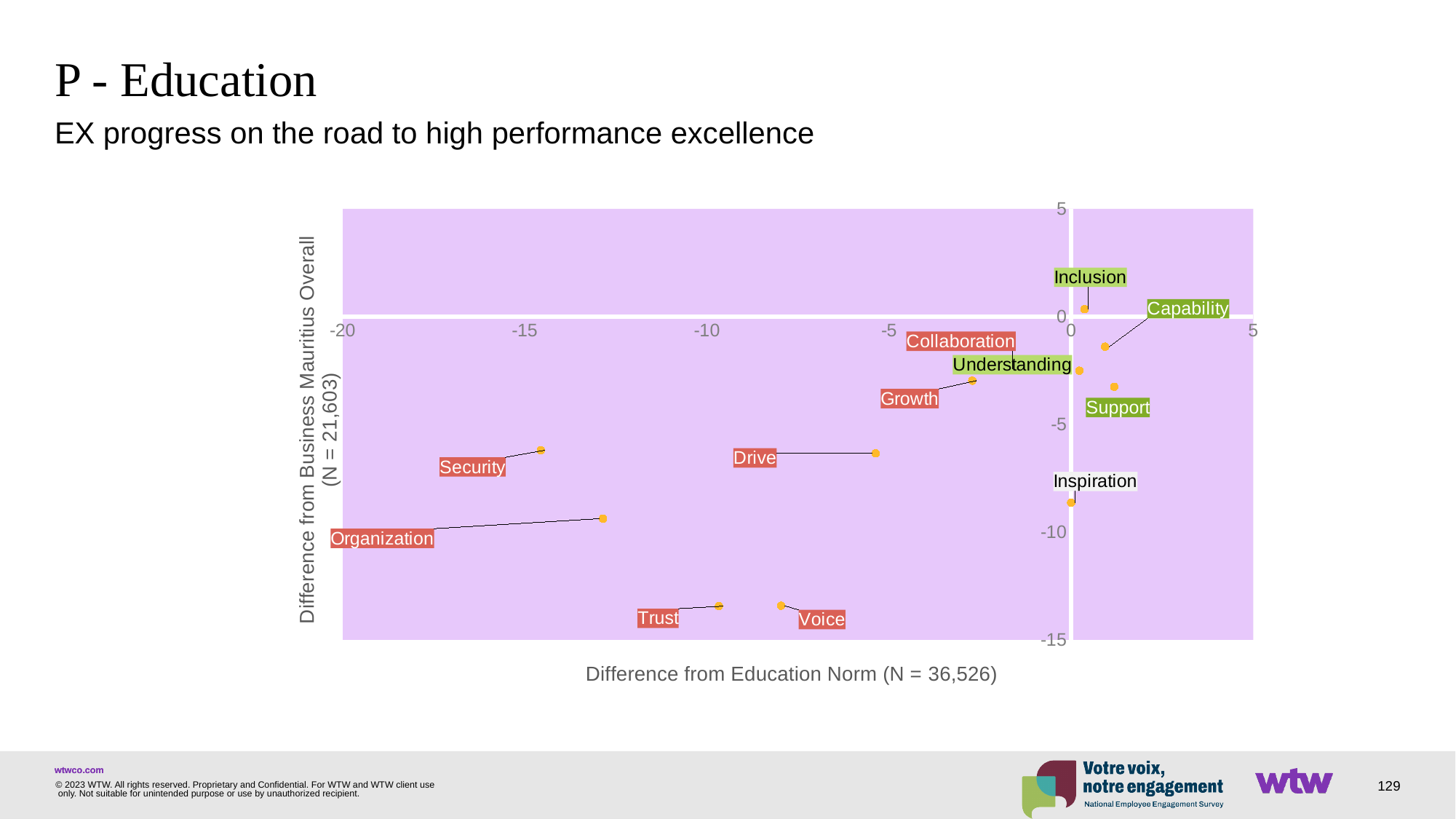
Which has the higher vertical-axis value, Organization or Security? Security Is the horizontal-axis value for Drive greater or less than -10? greater Is the vertical-axis value for Inclusion greater or less than 0? greater Is the vertical-axis value for Inspiration greater or less than -5? less What is the label of the horizontal axis? Difference from Education Norm (N = 36,526) What kind of chart is shown on the slide? scatter plot How many labelled points are plotted on the chart? 12 What is the label of the vertical axis? Difference from Business Mauritius Overall (N = 21,603) Which labelled point is furthest to the left on the horizontal axis (Difference from Education Norm)? Security Which labelled point has the highest value on the vertical axis (Difference from Business Mauritius Overall)? Inclusion